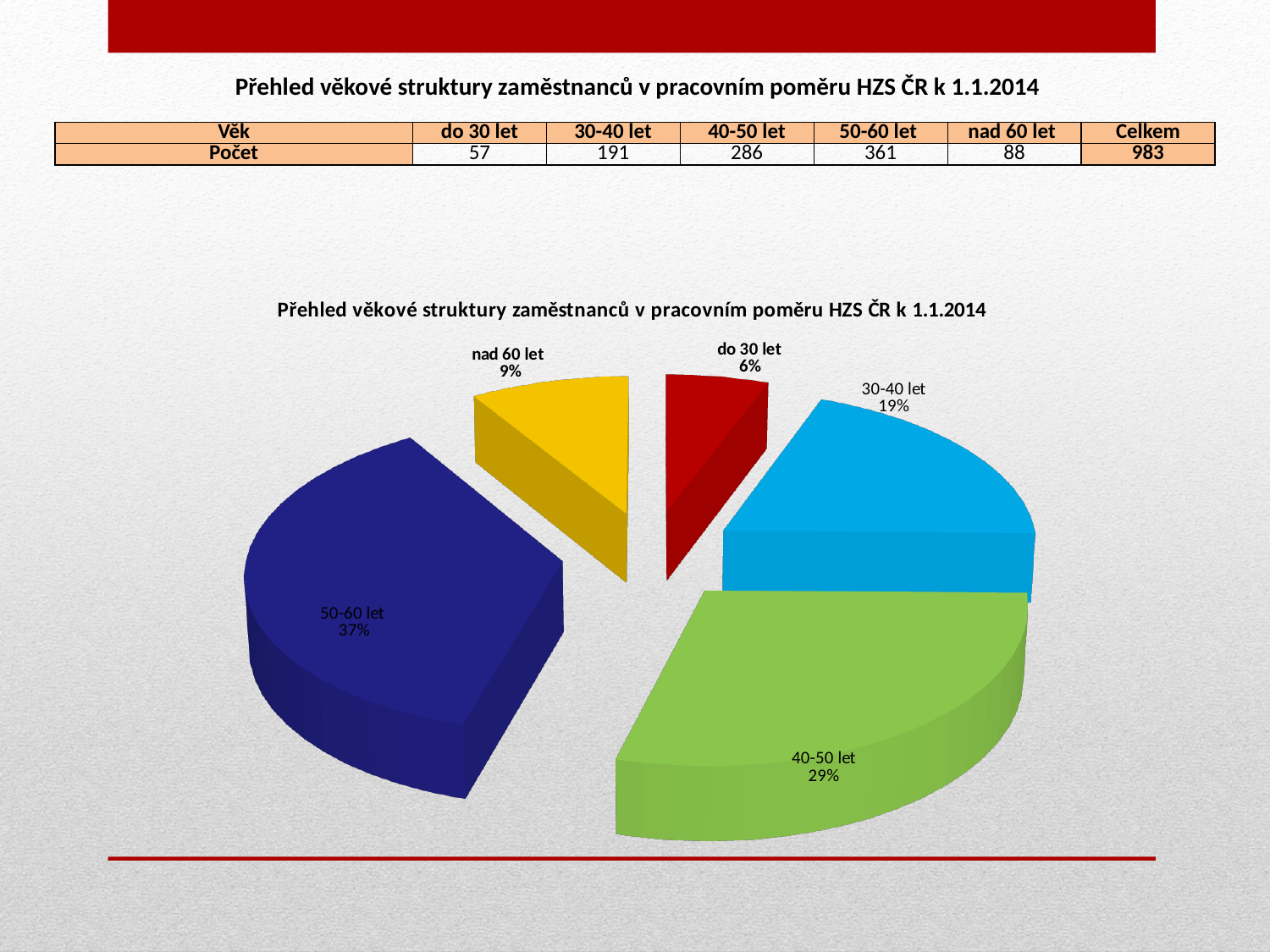
What share of the pie does the 'nad 60 let' slice represent? 9% What is the title of the pie chart? Přehled věkové struktury zaměstnanců v pracovním poměru HZS ČR k 1.1.2014 Which age group has the largest slice of the pie? 50-60 let What share of the pie does the '30-40 let' slice represent? 19% How many slices does the pie chart have? 5 What share of the pie does the 'do 30 let' slice represent? 6% What kind of chart is shown on the slide? pie chart Which slice is larger, '30-40 let' or 'nad 60 let'? 30-40 let What is the difference in percentage points between the '50-60 let' slice and the '40-50 let' slice? 8 percentage points Which age group has the smallest slice of the pie? do 30 let